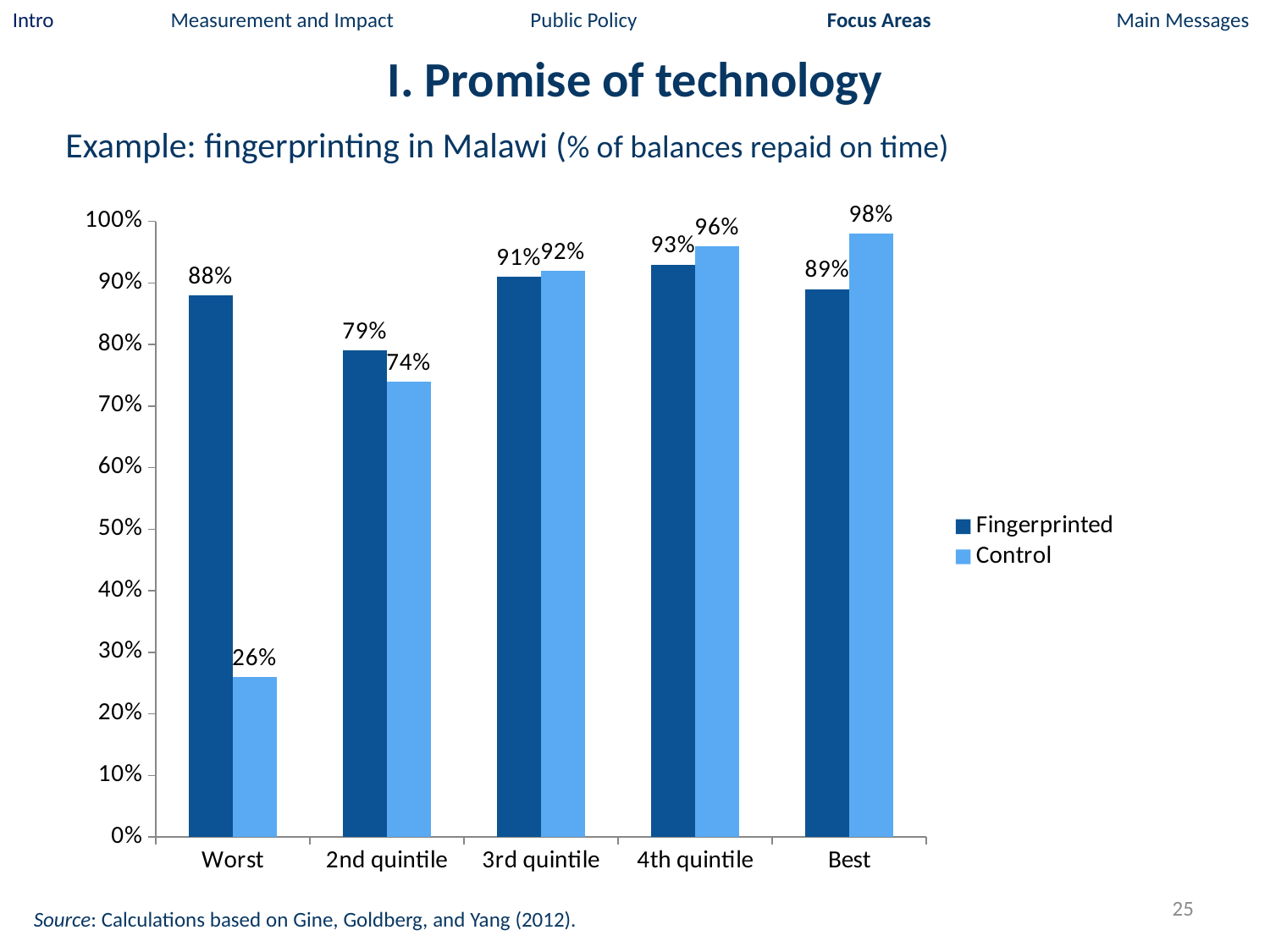
Which series is shown in the lighter blue colour? Control How many series does the legend list? 2 What is the Fingerprinted value for the Best quintile? 89% What kind of chart is shown on the slide? Bar chart What is the Control value for the 2nd quintile? 74% What is the difference between the Fingerprinted and Control values for the Worst quintile? 62% What is the Control value for the Worst quintile? 26% How many categories are shown on the x axis? 5 Which category has the lowest Control value? Worst Which category has the highest Control value? Best For the 2nd quintile, which is larger: the Fingerprinted value or the Control value? Fingerprinted What is the Fingerprinted value for the Worst quintile? 88%